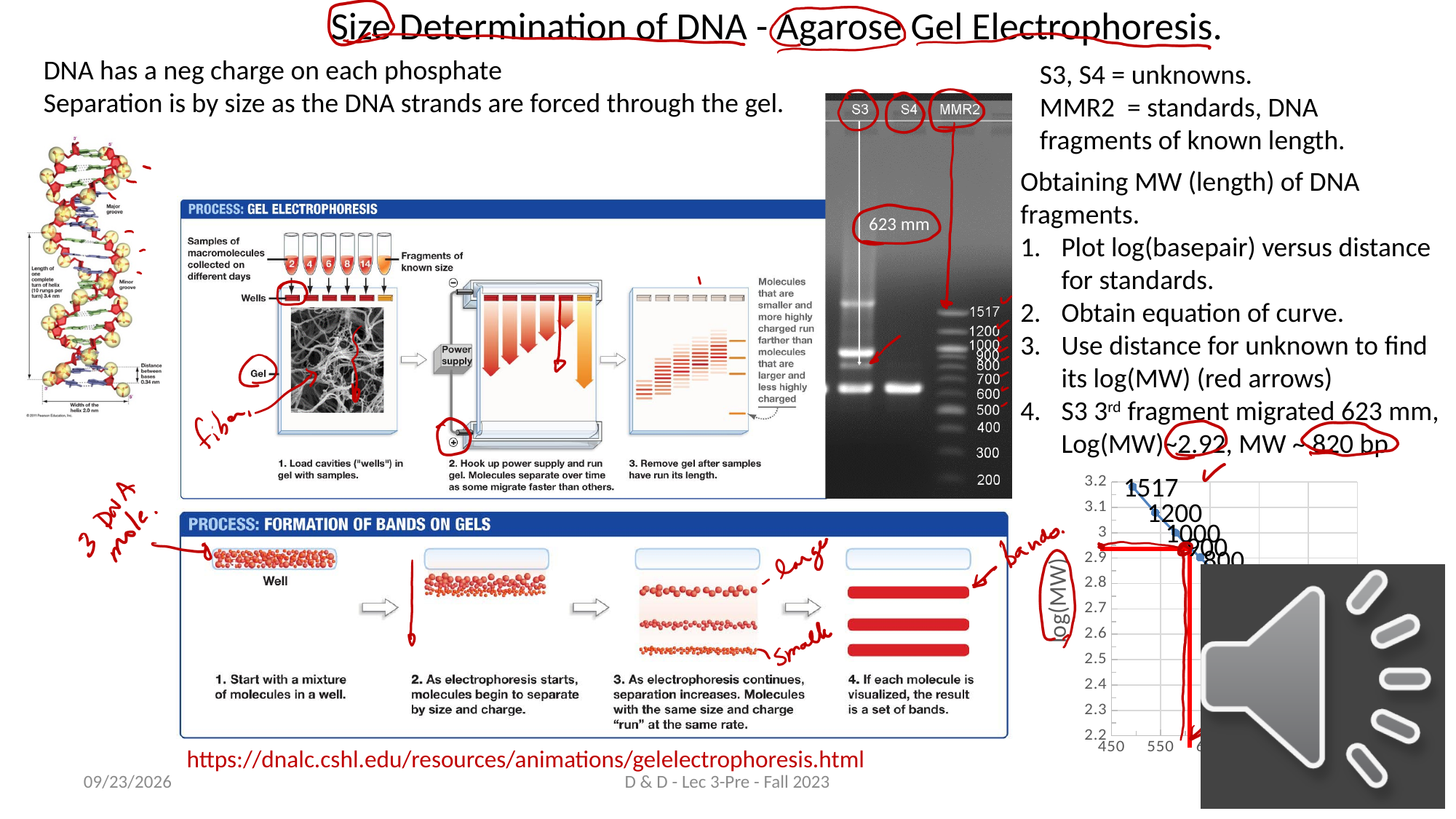
On the chart in the bottom right, which data label is attached to the highest plotted point? 1517 On the chart in the bottom right, what is the lowest tick value shown on the vertical axis? 2.2 On the chart in the bottom right, which plotted point has the higher log(MW): the one labelled 1517 or the one labelled 900? 1517 On the chart in the bottom right, is the log(MW) value of the point labelled 800 greater or less than 3? less On the chart in the bottom right, is the log(MW) value of the point labelled 1517 greater or less than 3.1? greater What is the label on the vertical axis of the chart in the bottom right of the slide? log(MW) On the chart in the bottom right, which plotted point has the lower log(MW): the one labelled 1200 or the one labelled 800? 800 On the chart in the bottom right, what is the highest tick value shown on the vertical axis? 3.2 On the chart in the bottom right, is the log(MW) value of the point labelled 1200 greater or less than 3? greater On the chart in the bottom right, what is the first tick value shown on the horizontal axis? 450 On the chart in the bottom right, do the plotted log(MW) values rise or fall as distance increases along the x axis? fall